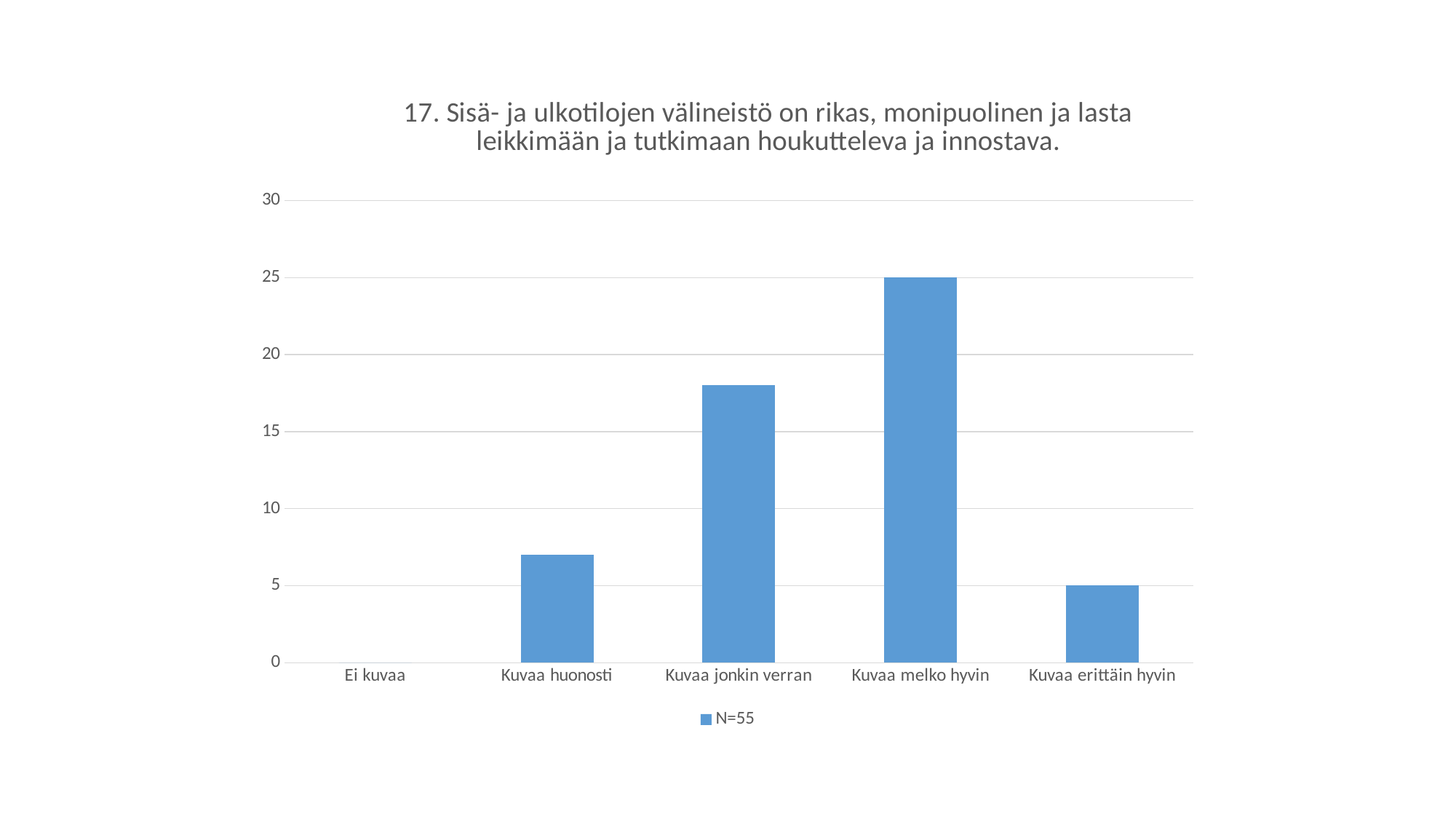
What kind of chart is shown on the slide? bar chart How many series does the legend list? 1 What is the legend entry for the series? N=55 What is the value for Kuvaa melko hyvin? 25 Which category has the highest value? Kuvaa melko hyvin What is the value for Kuvaa erittäin hyvin? 5 Is the value for Kuvaa jonkin verran greater or less than 15? greater What is the value for Ei kuvaa? 0 Is the value for Kuvaa huonosti greater or less than 10? less What is the difference between the values for Kuvaa melko hyvin and Kuvaa erittäin hyvin? 20 How many categories are shown on the x axis? 5 Which category has the lowest value? Ei kuvaa